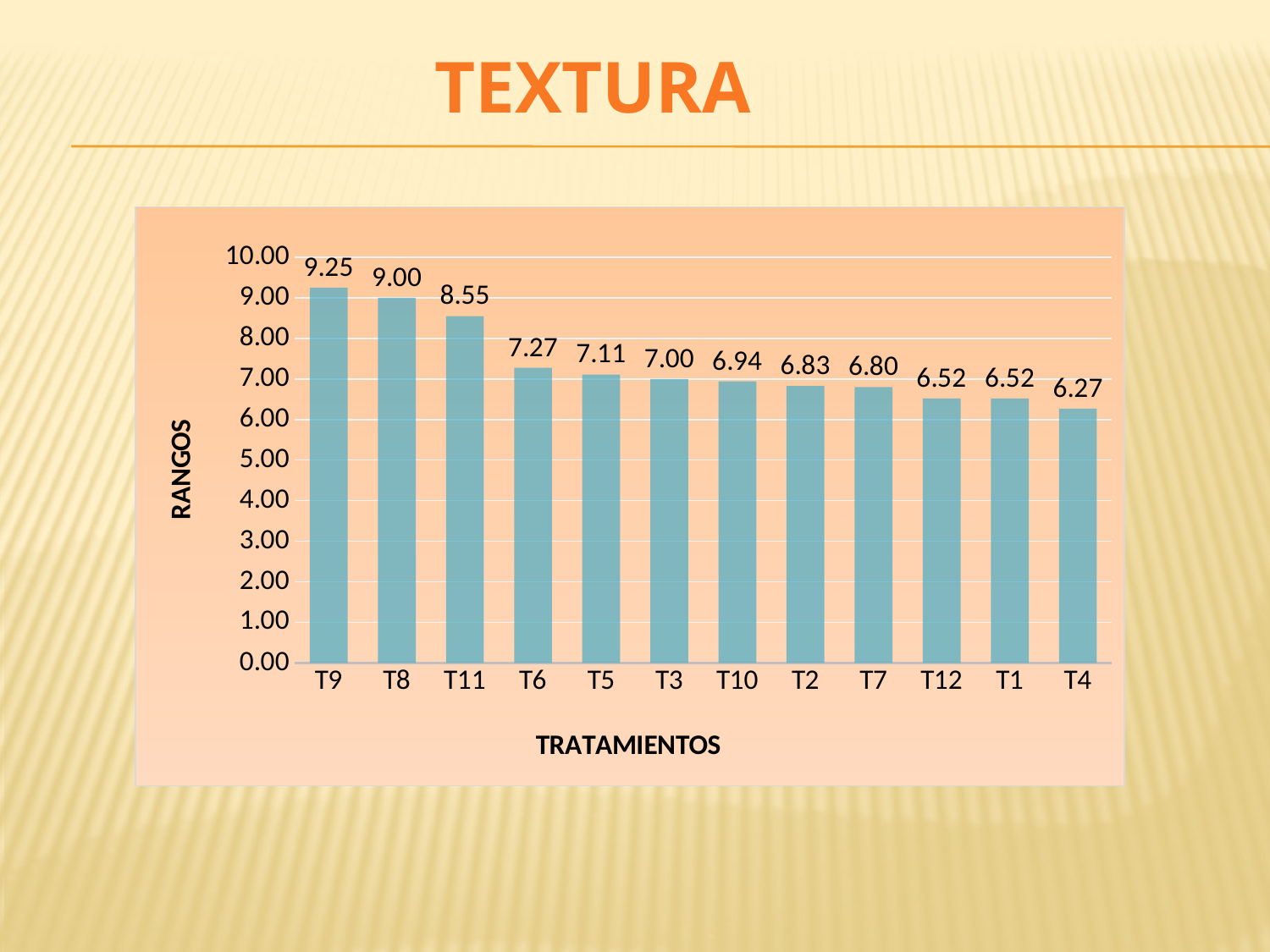
How many treatments are shown on the x axis? 12 What kind of chart is shown? Bar chart Which treatment has the lowest value? T4 What is the value for T11? 8.55 What is the value for T10? 6.94 Which treatment has the highest value? T9 What is the value for T9? 9.25 Which has a larger value, T8 or T11? T8 What is the difference between the values for T9 and T8? 0.25 What is the label of the y axis? RANGOS Is the value for T11 greater or less than 8.00? greater What is the difference between the values for T6 and T4? 1.00